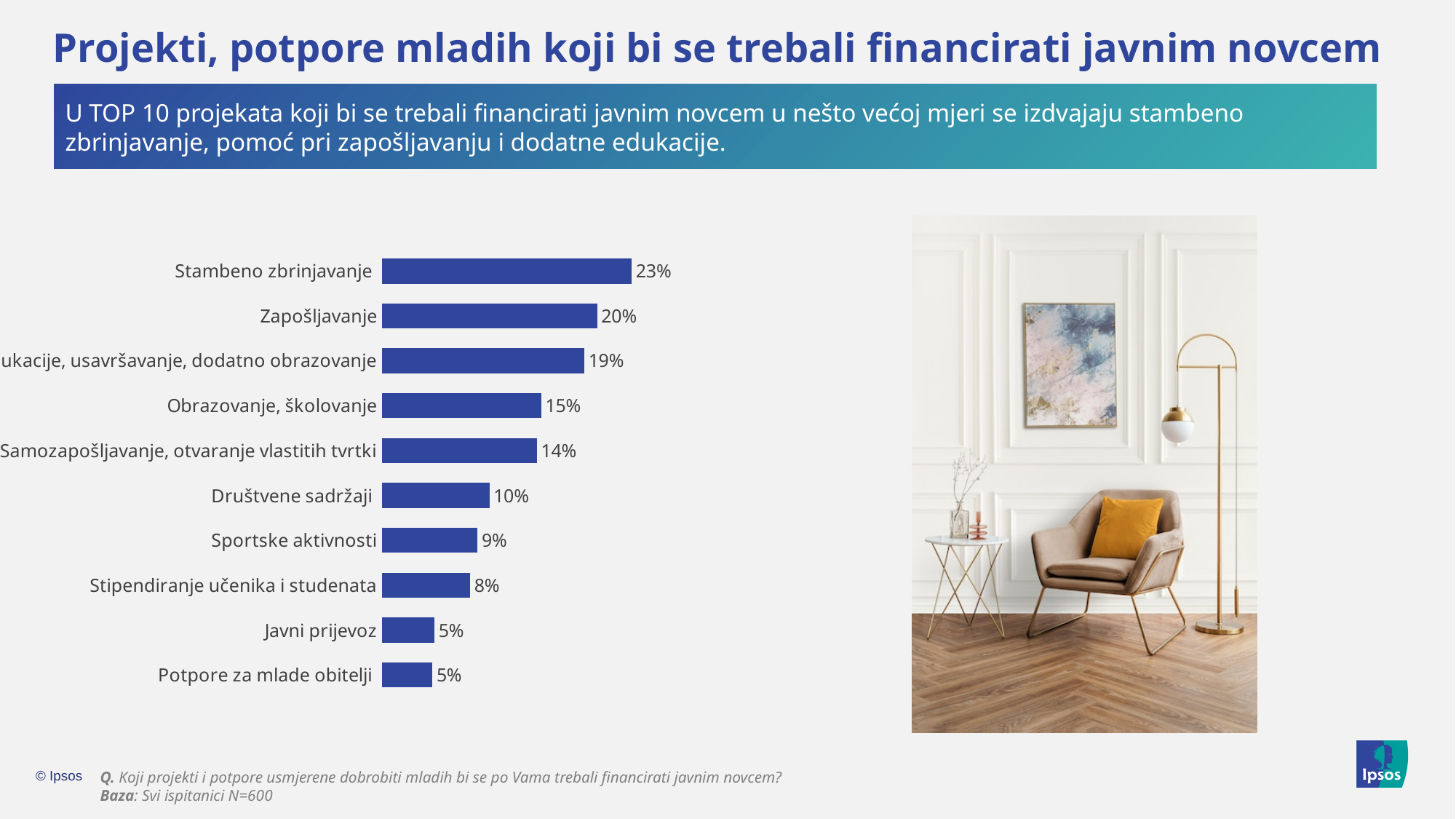
What value is shown for Zapošljavanje? 20% Which is larger, the value for Sportske aktivnosti or the value for Javni prijevoz? Sportske aktivnosti What is the base (Baza) stated at the bottom of the slide? Svi ispitanici N=600 What value is shown for Stambeno zbrinjavanje? 23% What is the difference between the values for Obrazovanje, školovanje and Društvene sadržaji? 5% How many categories are shown in the chart? 10 Which category has the highest value? Stambeno zbrinjavanje What value is shown for Samozapošljavanje, otvaranje vlastitih tvrtki? 14% What is the difference between the values for Stambeno zbrinjavanje and Zapošljavanje? 3% What value is shown for Stipendiranje učenika i studenata? 8% What kind of chart is shown on the slide? Bar chart What value is shown for Potpore za mlade obitelji? 5%